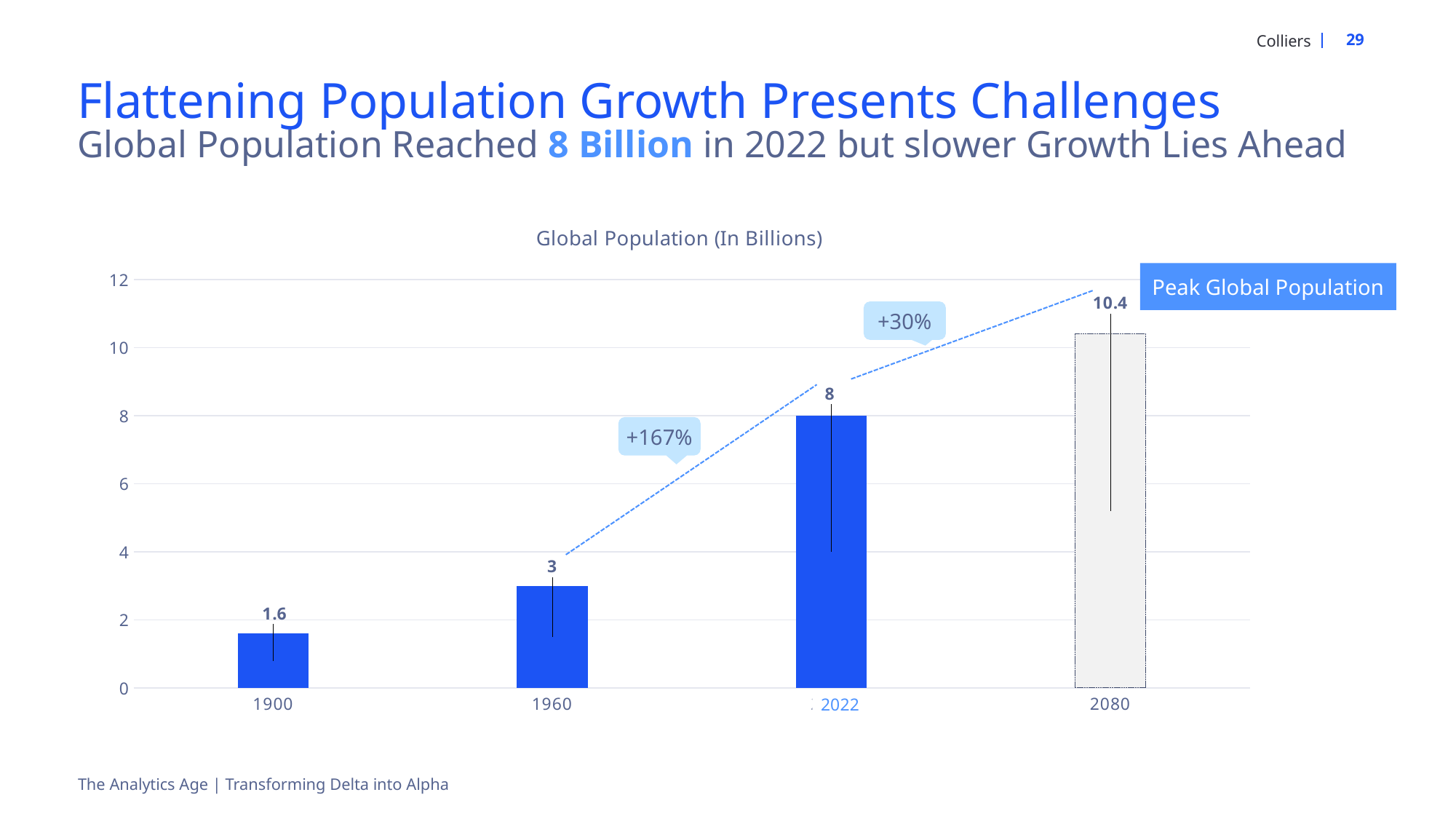
What is the difference between the 2080 value and the 2022 value? 2.4 Which is larger, the value for 1960 or the value for 1900? 1960 What is the global population value shown for 1900? 1.6 What is the global population value shown for 2080? 10.4 Which year has the lowest global population value on the chart? 1900 What kind of chart is shown on the slide? Bar chart What is the title of the chart? Global Population (In Billions) What is the difference between the 2022 value and the 1960 value? 5 What is the global population value shown for 1960? 3 How many years (bars) are shown on the chart? 4 What is the global population value shown for 2022? 8 Which year has the highest global population value on the chart? 2080